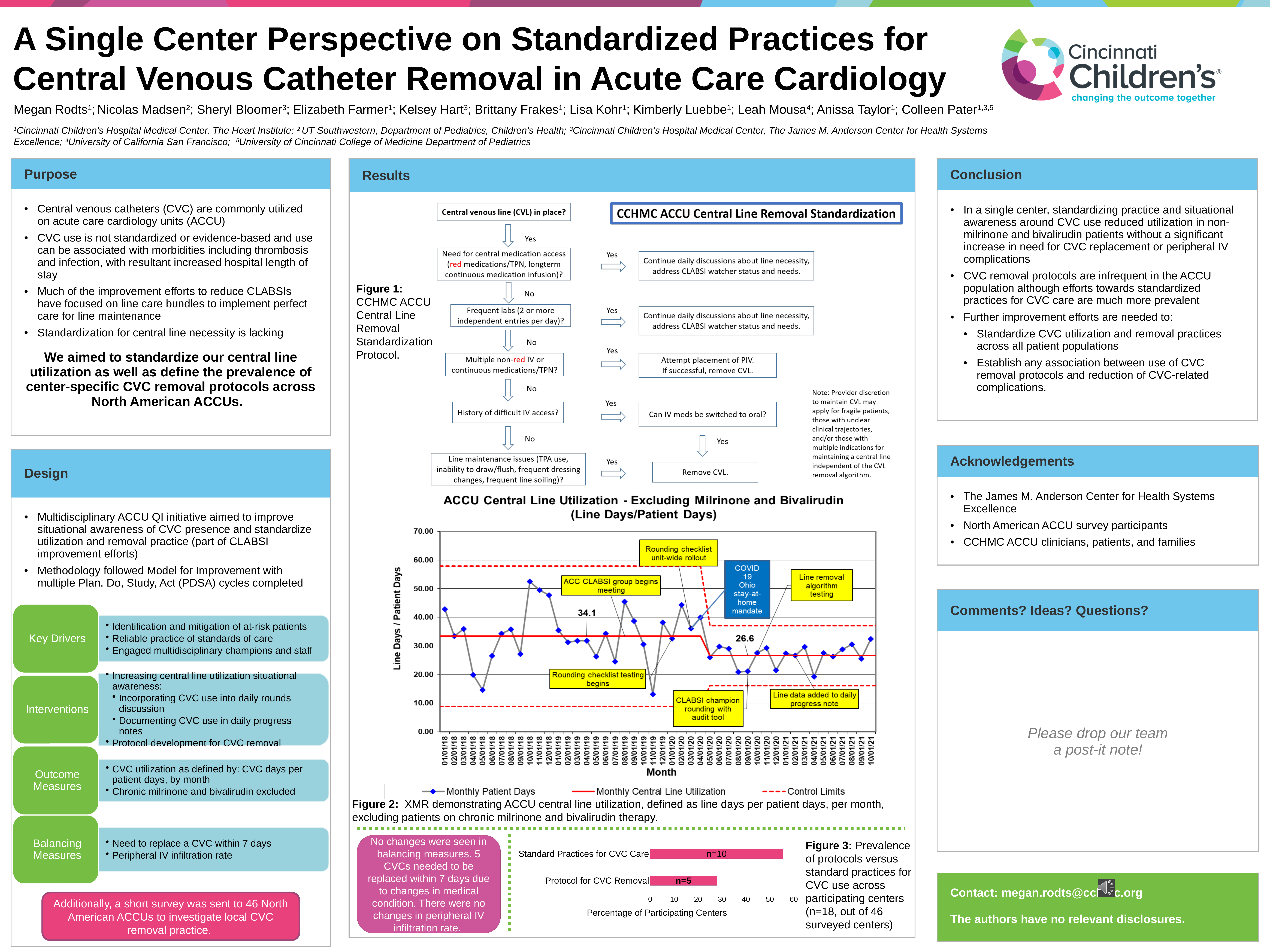
In Figure 3 (prevalence of protocols versus standard practices), what is the label printed on the bar for Standard Practices for CVC Care? n=10 In Figure 3 (prevalence of protocols versus standard practices), which category has the longer bar? Standard Practices for CVC Care In Figure 3 (prevalence of protocols versus standard practices), how many categories are plotted? 2 In Figure 2, the ACCU Central Line Utilization chart, what is the value labelled on the first (earlier) central line utilization center line? 34.1 In Figure 3 (prevalence of protocols versus standard practices), what is the title of the horizontal axis? Percentage of Participating Centers In Figure 2, the ACCU Central Line Utilization chart, what is the difference between the two labelled center line values, 34.1 and 26.6? 7.5 In Figure 3 (prevalence of protocols versus standard practices), what is the label printed on the bar for Protocol for CVC Removal? n=5 In Figure 2, the ACCU Central Line Utilization chart, what is the value labelled on the second (later) central line utilization center line? 26.6 What kind of chart is Figure 3, the chart showing prevalence of protocols versus standard practices? bar chart In Figure 3 (prevalence of protocols versus standard practices), is the percentage for Protocol for CVC Removal greater or less than 40? less In Figure 2, the ACCU Central Line Utilization chart, how many series does the legend list? 3 In Figure 3 (prevalence of protocols versus standard practices), is the percentage for Standard Practices for CVC Care greater or less than 50? greater